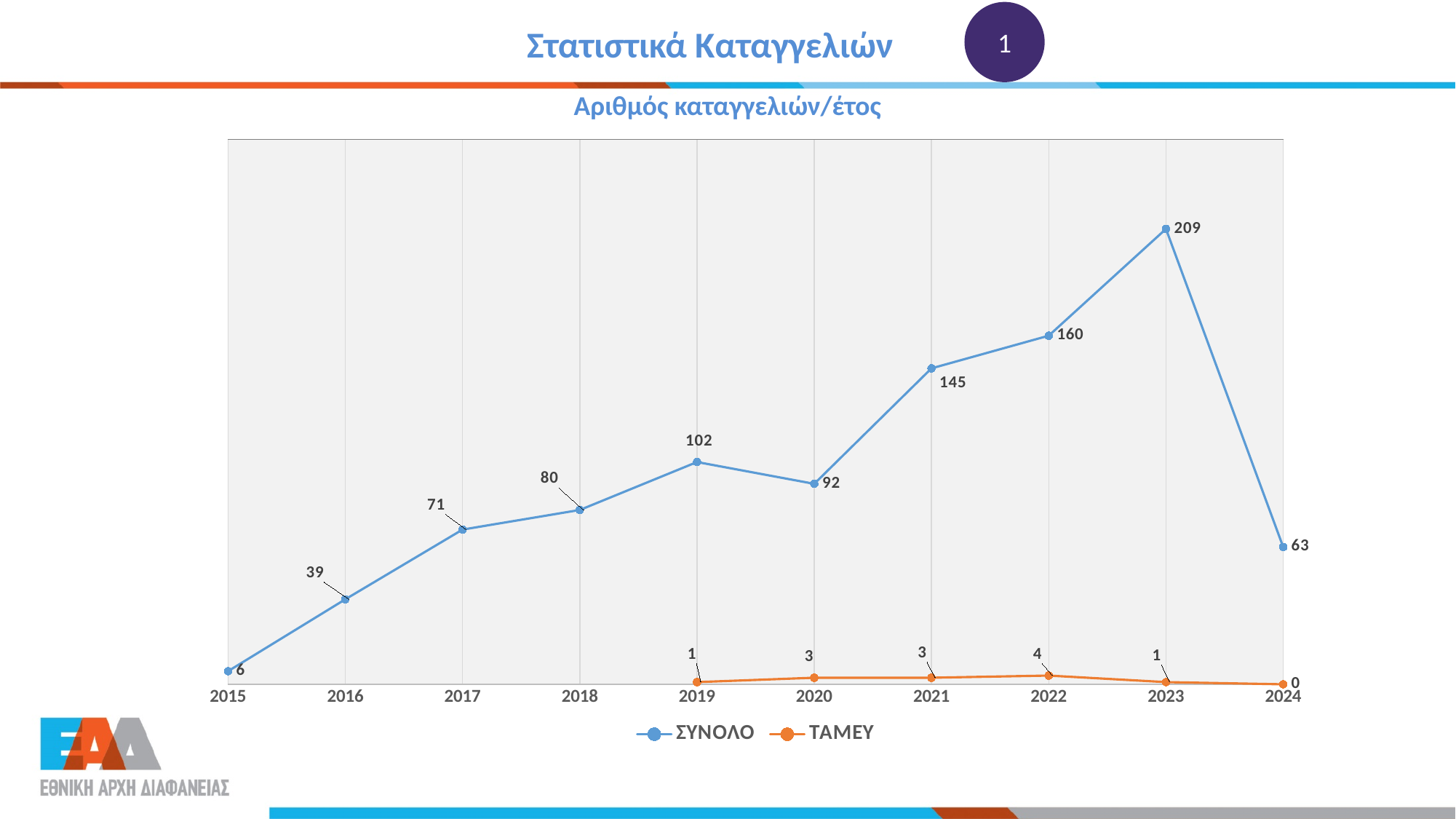
How many years are shown on the x axis? 10 What type of chart is shown on the slide? line chart What is the ΣΥΝΟΛΟ value for 2023? 209 Which is larger, the ΣΥΝΟΛΟ value for 2019 or for 2020? 2019 How many series does the legend list? 2 What is the ΣΥΝΟΛΟ value for 2019? 102 In which year is the ΣΥΝΟΛΟ value lowest? 2015 What is the ΤΑΜΕΥ value for 2022? 4 What is the ΤΑΜΕΥ value for 2024? 0 What is the title of the chart? Αριθμός καταγγελιών/έτος What is the difference between the ΣΥΝΟΛΟ values for 2023 and 2024? 146 In which year is the ΣΥΝΟΛΟ value highest? 2023